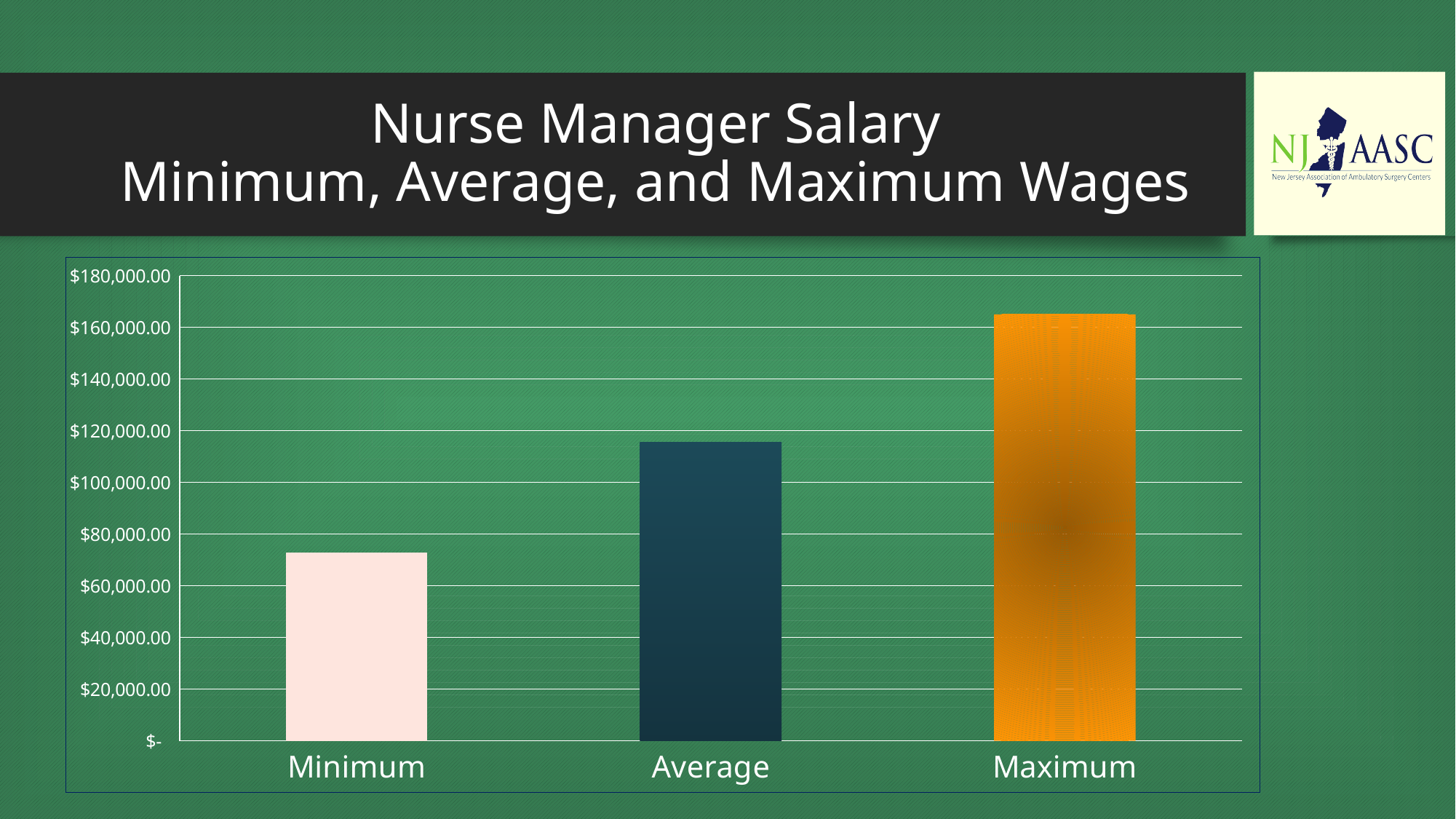
Is the value for Maximum greater or less than $180,000.00? less What kind of chart is shown on the slide? bar chart Is the value for Average greater or less than $100,000.00? greater Which is larger, the value for Average or the value for Minimum? Average Is the value for Minimum greater or less than $60,000.00? greater Which category has the lowest value? Minimum How many categories are plotted on the chart? 3 What is the title of the slide containing the chart? Nurse Manager Salary Minimum, Average, and Maximum Wages Do the values rise or fall moving from Minimum to Maximum along the x axis? rise Which category has the highest value? Maximum